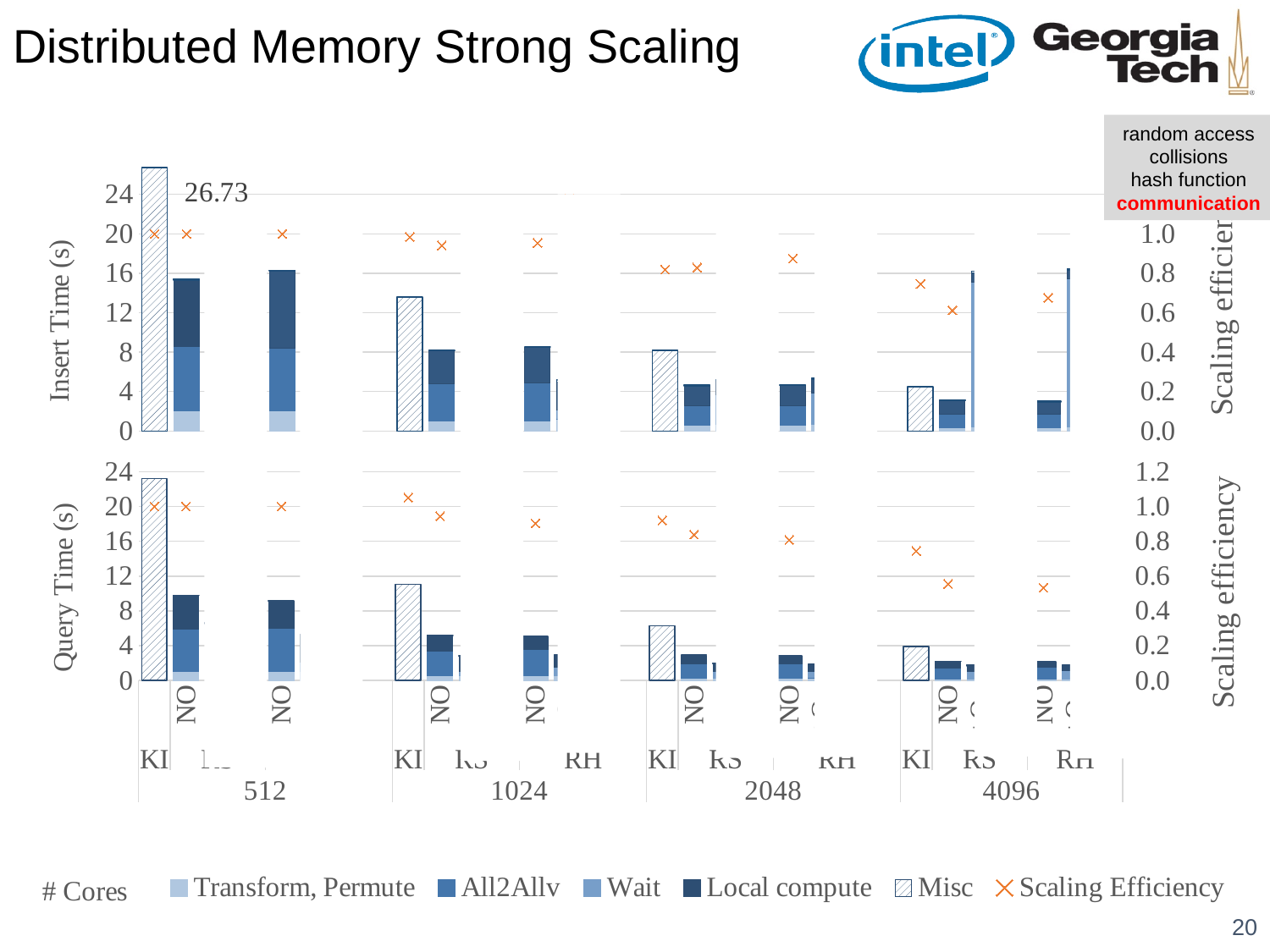
What is the label on the x axis shared by the charts? # Cores In the bottom chart (Query Time), which KI bar is taller: the one at 512 cores or the one at 4096 cores? 512 cores In the bottom chart (Query Time), is the KI bar at 512 cores greater or less than 20? greater How many series does the legend at the bottom of the slide list? 6 In the bottom chart (Query Time), is the KI bar at 4096 cores greater or less than 8? less In the top chart (Insert Time), does the height of the KI bar rise or fall as the number of cores increases? fall In the top chart (Insert Time), at which core count is the KI bar tallest? 512 What kind of chart is the top chart (Insert Time)? combination bar and line chart (stacked bars with scaling efficiency markers) How many core counts are shown along the x axis of the charts? 4 In the top chart (Insert Time), is the KI bar at 1024 cores greater or less than 12? greater What is the label on the left y axis of the top chart? Insert Time (s) In the top chart (Insert Time), what is the labelled value of the KI bar at 512 cores? 26.73